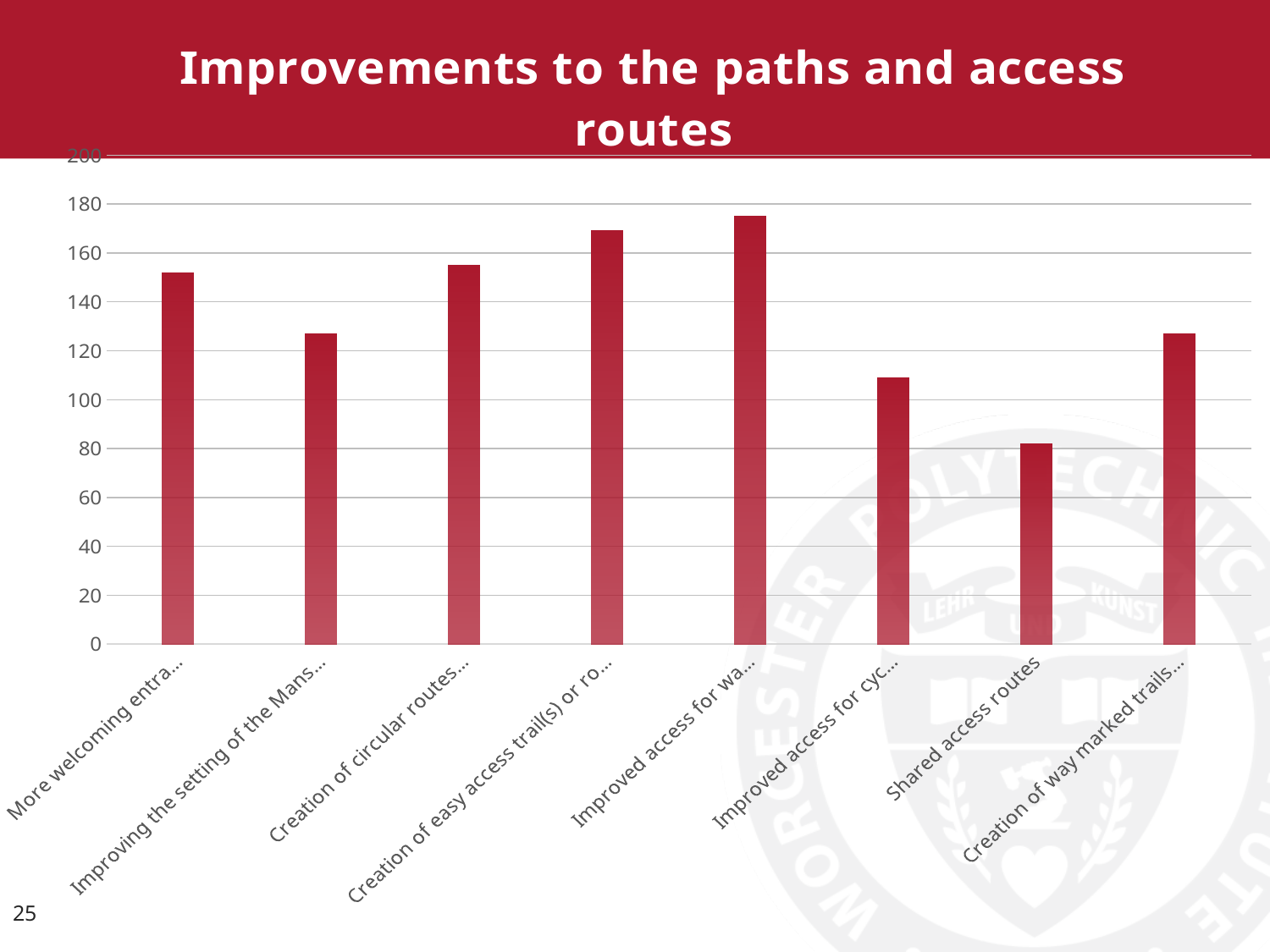
Is the value for "Shared access routes" greater or less than 100? less Is the value for "More welcoming entra..." greater or less than 140? greater Is the value for "Creation of easy access trail(s) or ro..." greater or less than 160? greater What kind of chart is shown on the slide? bar chart How many bars (categories) are plotted in the chart? 8 Which category has the lowest bar? Shared access routes Which is larger, the value for "Shared access routes" or the value for "Improved access for cyc..."? Improved access for cyc... Which is larger, the value for "Creation of circular routes..." or the value for "Improving the setting of the Mans..."? Creation of circular routes... Which category has the highest bar? Improved access for wa... What is the title of the chart? Improvements to the paths and access routes